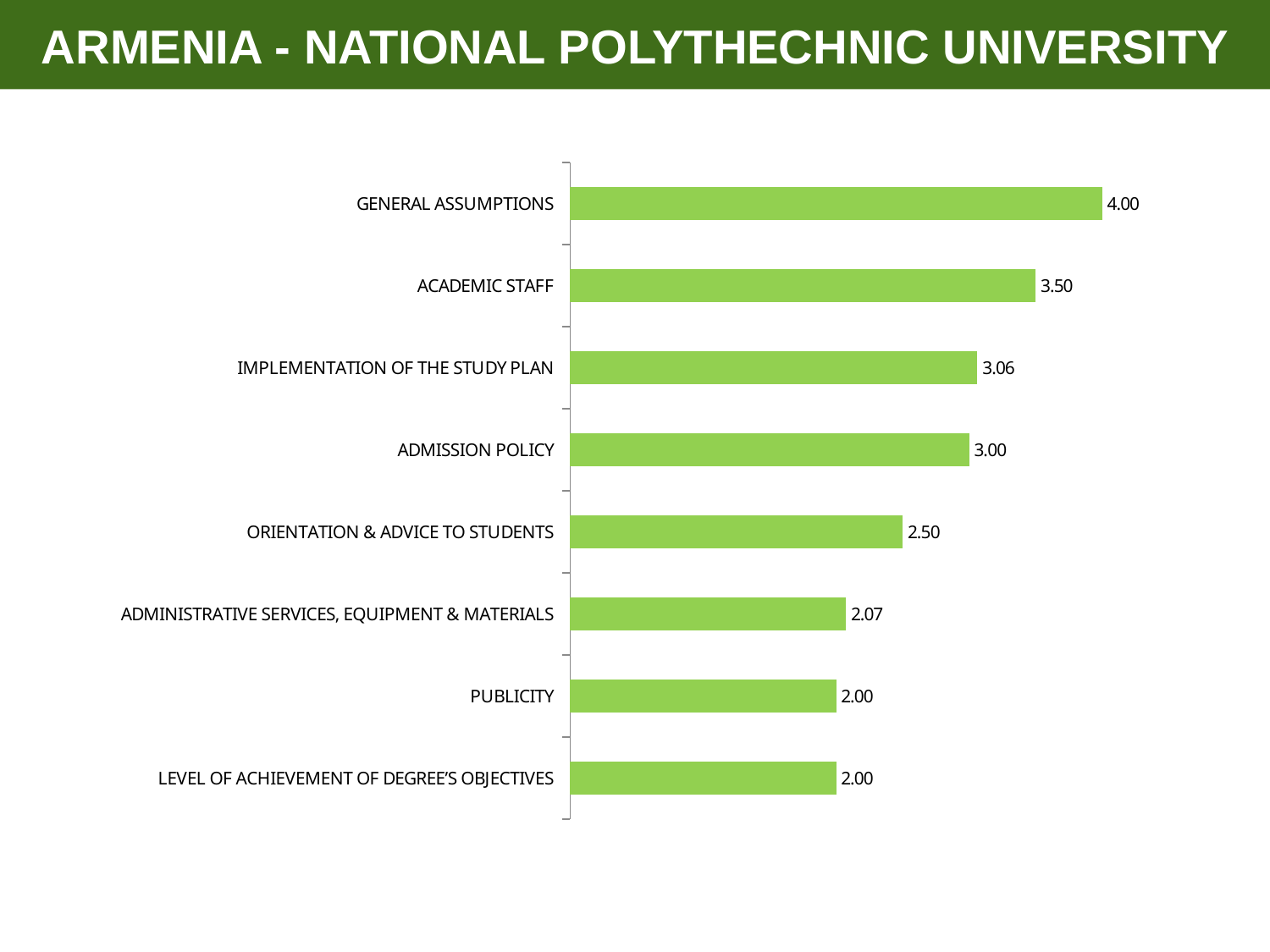
Which is larger, the value for ACADEMIC STAFF or the value for ORIENTATION & ADVICE TO STUDENTS? ACADEMIC STAFF What is the value for GENERAL ASSUMPTIONS? 4.00 What kind of chart is shown on the slide? Bar chart What is the value for ORIENTATION & ADVICE TO STUDENTS? 2.50 What is the difference between the values for GENERAL ASSUMPTIONS and PUBLICITY? 2.00 What is the value for IMPLEMENTATION OF THE STUDY PLAN? 3.06 Which category has the highest value? GENERAL ASSUMPTIONS What is the difference between the values for ACADEMIC STAFF and ADMISSION POLICY? 0.50 What is the value for PUBLICITY? 2.00 What is the value for ADMINISTRATIVE SERVICES, EQUIPMENT & MATERIALS? 2.07 What colour are the bars in the chart? Green How many categories are shown in the chart? 8